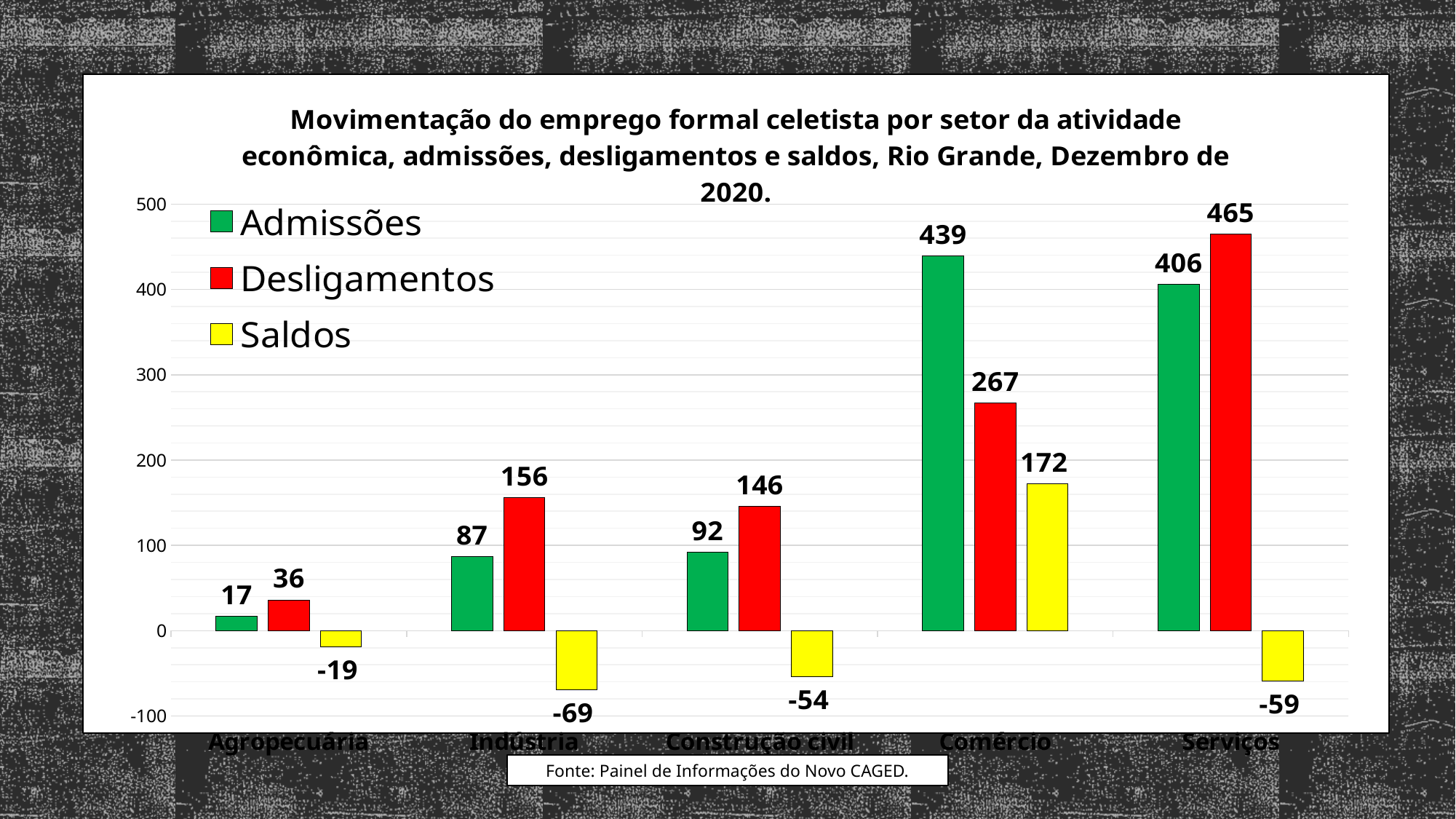
How many series does the legend list? 3 What is the value of Saldos for Serviços? -59 What is the value of Desligamentos for Indústria? 156 How many sectors are shown on the x axis? 5 What kind of chart is shown on the slide? Bar chart Which is larger for Construção civil, Admissões or Desligamentos? Desligamentos What is the value of Admissões for Comércio? 439 What colour are the Saldos bars? Yellow What is the difference between Desligamentos and Admissões for Serviços? 59 Which sector has the lowest value of Admissões? Agropecuária Which sector has the highest value of Desligamentos? Serviços Which sector is the only one with a positive Saldos value? Comércio